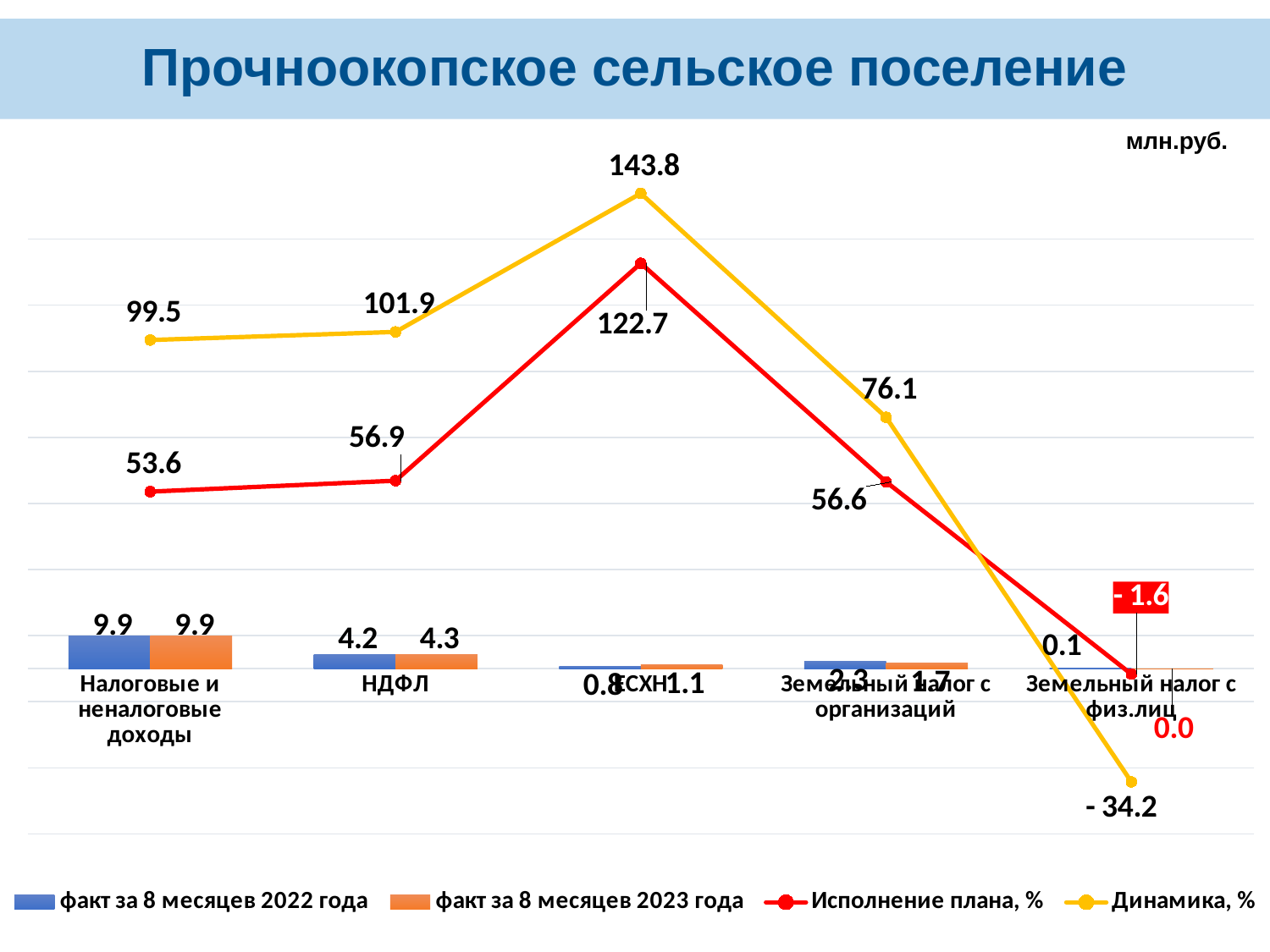
What is the value of Исполнение плана, % for НДФЛ? 56.9 What is the difference between факт за 8 месяцев 2022 года and факт за 8 месяцев 2023 года for Земельный налог с организаций? 0.6 What is the value of факт за 8 месяцев 2022 года for Налоговые и неналоговые доходы? 9.9 Which category has the highest value of Динамика, %? ЕСХН How many series does the legend list? 4 For НДФЛ, which is larger: факт за 8 месяцев 2022 года or факт за 8 месяцев 2023 года? факт за 8 месяцев 2023 года What unit is indicated in the top right corner of the chart? млн.руб. What kind of chart is shown on the slide? A combined bar and line chart Which category has the highest value of Исполнение плана, %? ЕСХН How many categories are shown on the x axis? 5 What is the value of Динамика, % for ЕСХН? 143.8 Which category has the lowest value of Динамика, %? Земельный налог с физ.лиц